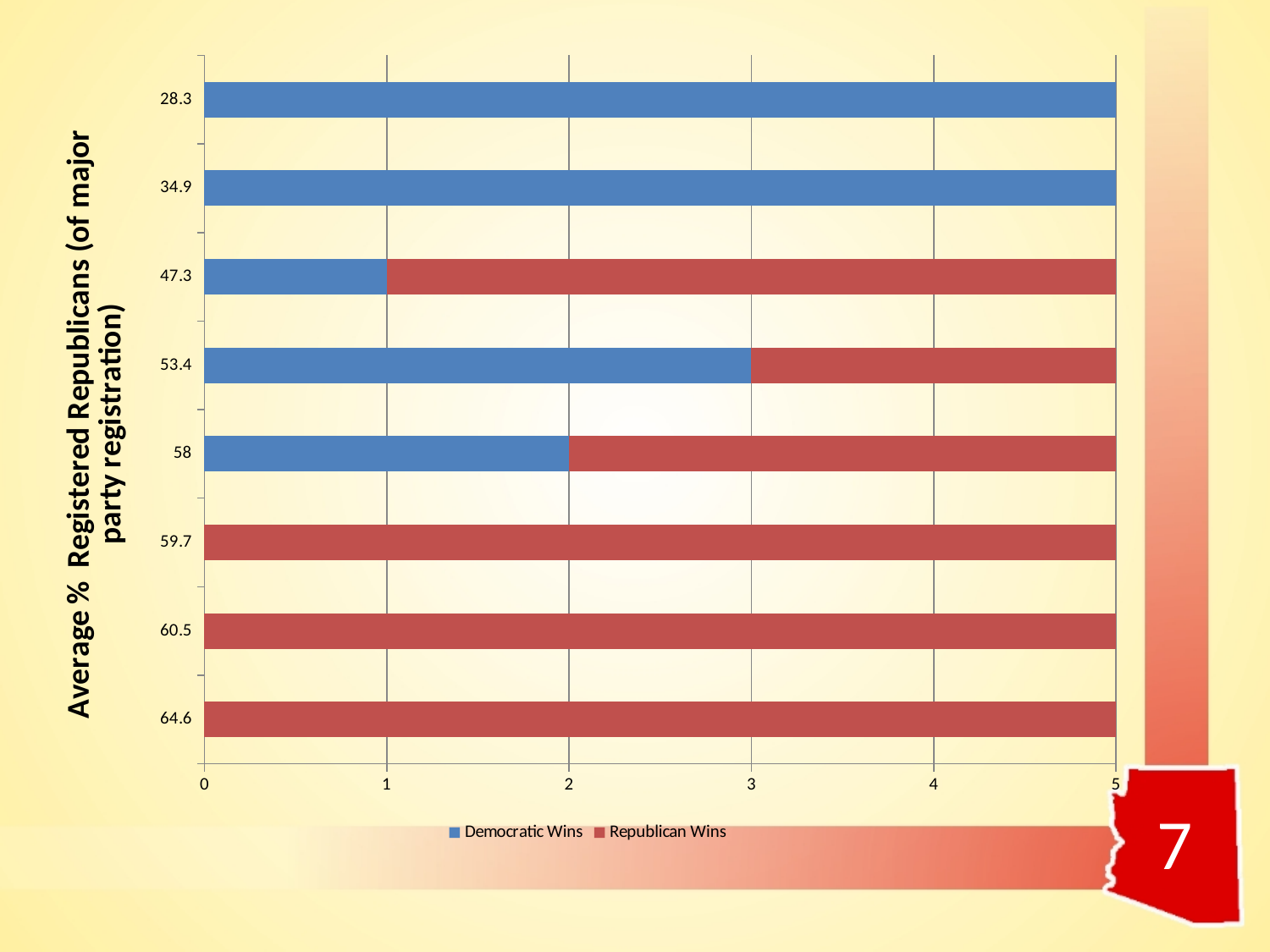
How many categories are plotted on the vertical axis? 8 What is the value of Democratic Wins for the 47.3 category? 1 What is the value of Republican Wins for the 53.4 category? 2 What is the total of the stacked bar for the 47.3 category? 5 Which colour represents Republican Wins in the legend? red What is the difference between Republican Wins and Democratic Wins for the 47.3 category? 3 What kind of chart is shown on the slide? stacked bar chart How many series does the legend list? 2 For the 53.4 category, which is larger: Democratic Wins or Republican Wins? Democratic Wins What is the title of the vertical axis? Average % Registered Republicans (of major party registration) What is the value of Democratic Wins for the 58 category? 2 What is the value of Democratic Wins for the 28.3 category? 5